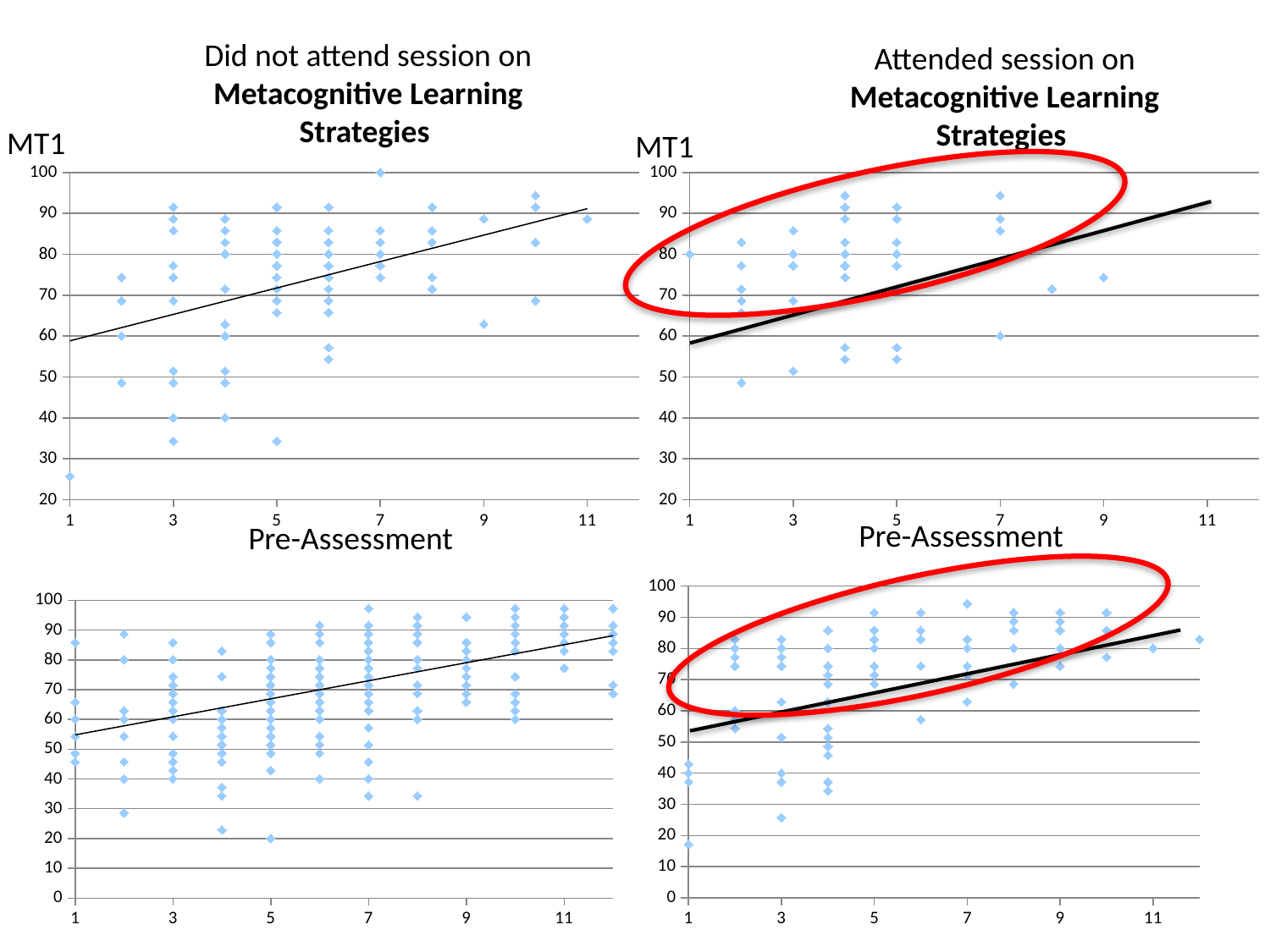
What is the label on the horizontal axis of the two top charts? Pre-Assessment What is the lowest value shown on the vertical axis of the top-left chart ('Did not attend session')? 20 In the bottom-left chart, is the lowest point at x = 5 greater or less than 30? less In the top-left chart ('Did not attend session'), is the MT1 value of the point at Pre-Assessment 1 greater or less than 30? less How many charts are shown on the slide? 4 What kind of chart is the top-left chart titled 'Did not attend session on Metacognitive Learning Strategies'? scatter chart In the top-left chart ('Did not attend session'), does the trend line rise or fall as Pre-Assessment increases? rise In the top-left chart ('Did not attend session'), at which Pre-Assessment value does the highest MT1 point occur? 7 What is the label on the vertical axis of the two top charts? MT1 In the bottom-right chart, is the lowest point at x = 1 greater or less than 20? less In the top-right chart ('Attended session'), does the trend line rise or fall as Pre-Assessment increases? rise